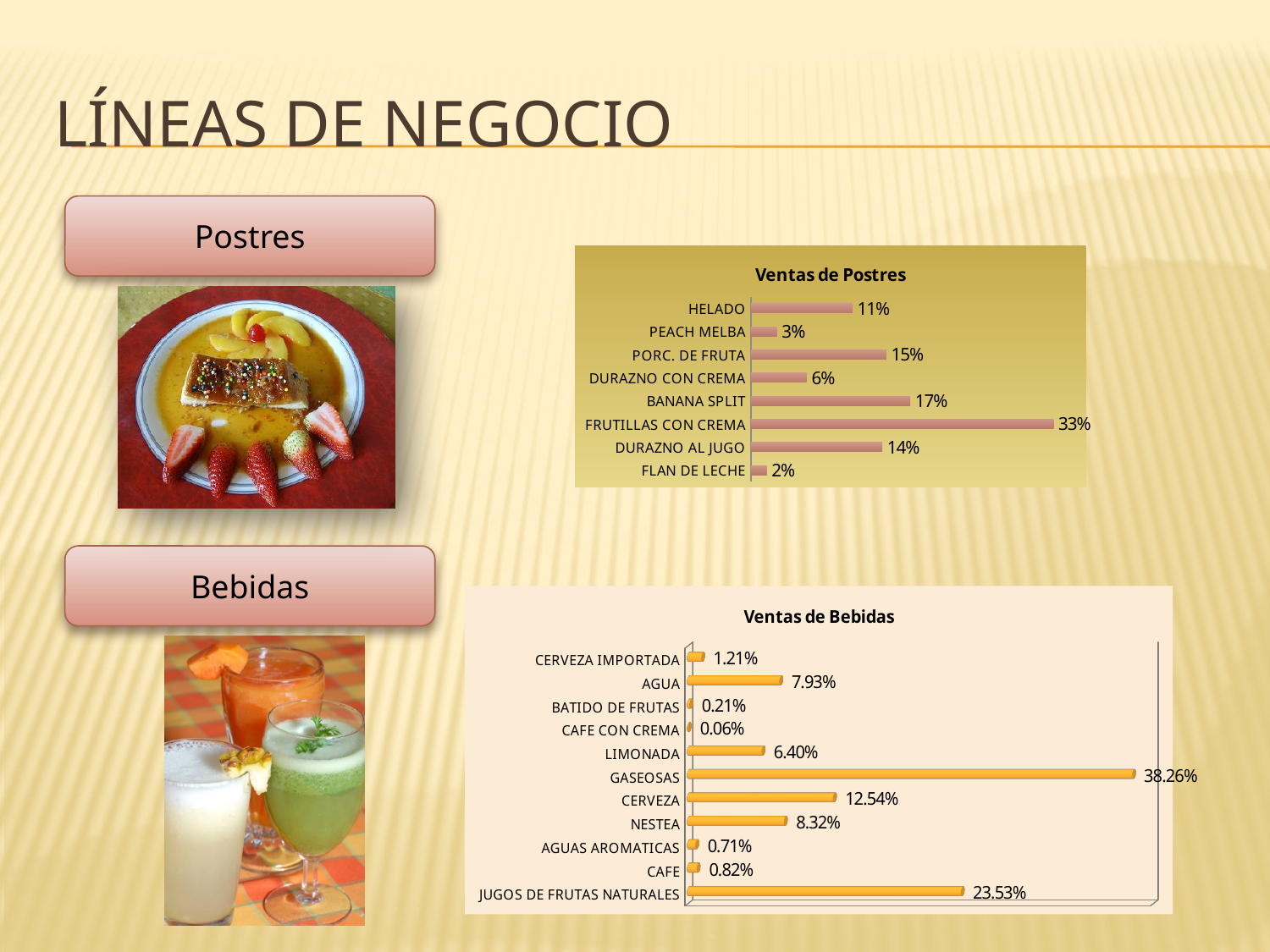
In the 'Ventas de Bebidas' chart, what is the value for GASEOSAS? 38.26% In the 'Ventas de Postres' chart, which is larger, HELADO or DURAZNO AL JUGO? DURAZNO AL JUGO In the 'Ventas de Bebidas' chart, which category has the lowest value? CAFE CON CREMA How many categories are shown in the 'Ventas de Bebidas' chart? 11 What type of chart is the 'Ventas de Bebidas' chart? Bar chart In the 'Ventas de Bebidas' chart, what is the difference between CERVEZA and NESTEA? 4.22% In the 'Ventas de Postres' chart, what is the difference between BANANA SPLIT and PORC. DE FRUTA? 2% In the 'Ventas de Postres' chart, what is the value for FRUTILLAS CON CREMA? 33% How many categories are shown in the 'Ventas de Postres' chart? 8 In the 'Ventas de Postres' chart, which category has the lowest value? FLAN DE LECHE In the 'Ventas de Bebidas' chart, what is the value for JUGOS DE FRUTAS NATURALES? 23.53% In the 'Ventas de Bebidas' chart, which is larger, AGUA or LIMONADA? AGUA